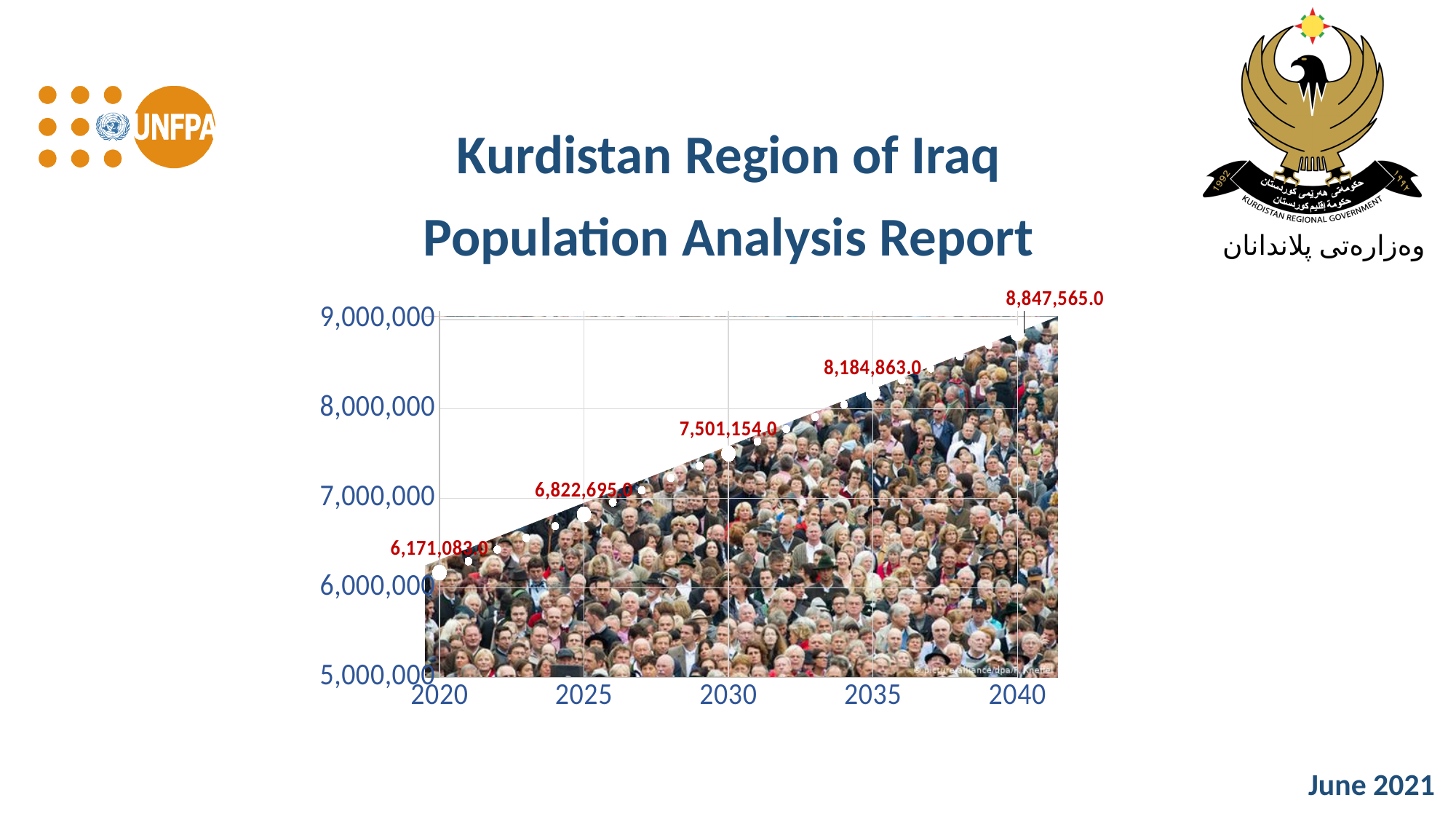
What is the population value shown for 2030? 7,501,154.0 What is the population value shown for 2040? 8,847,565.0 Which year has the lowest labelled population value? 2020 What is the difference between the 2025 and 2020 population values? 651,612.0 Is the population value for 2038 greater or less than 8,000,000? greater What is the population value shown for 2035? 8,184,863.0 What is the difference between the 2040 and 2020 population values? 2,676,482.0 What kind of chart is shown on the slide? line chart Do the population values rise or fall from 2020 to 2040? rise Which is larger, the population value for 2025 or for 2035? 2035 Which year has the highest labelled population value? 2040 What is the population value shown for 2020? 6,171,083.0